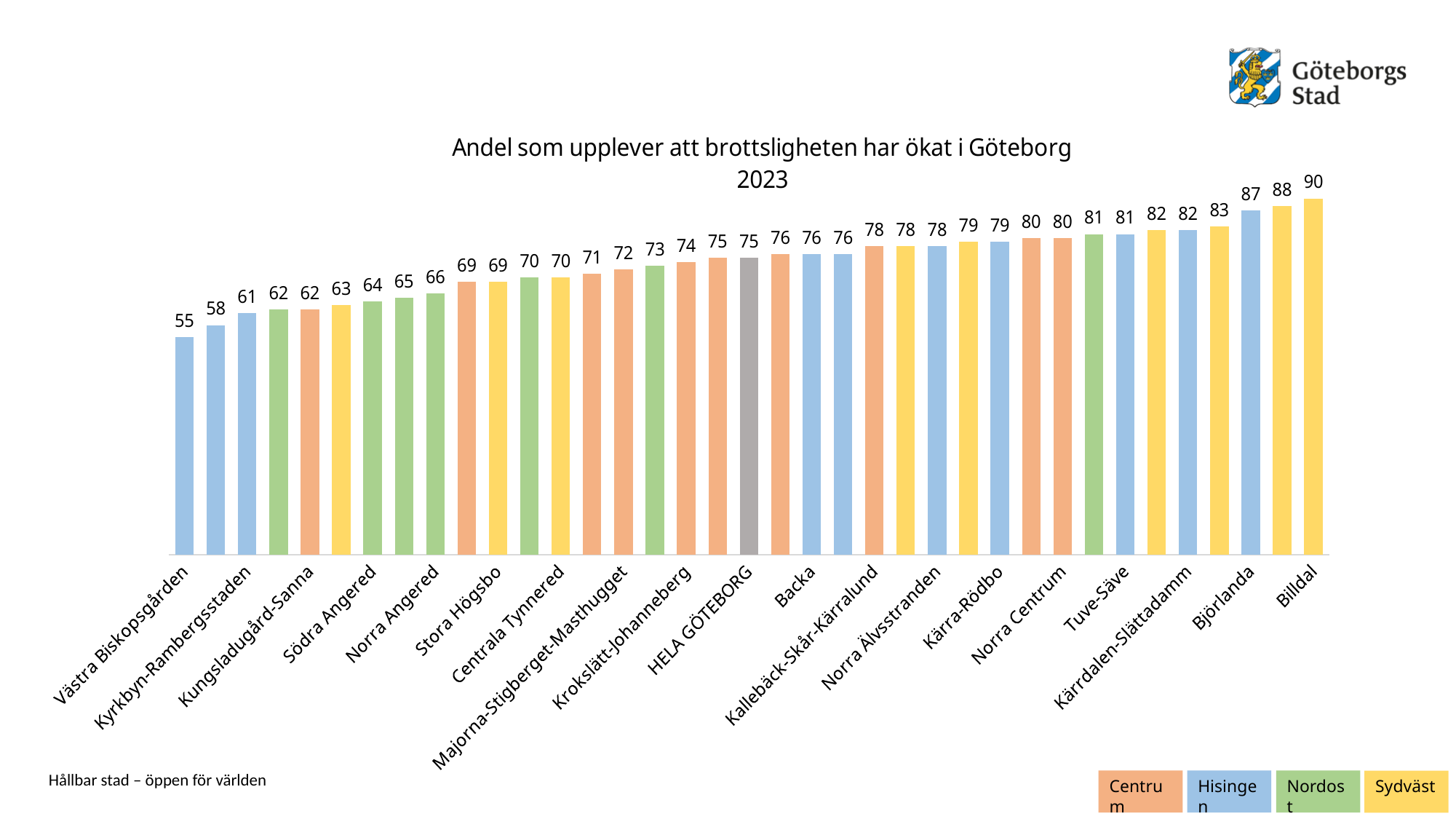
Which is larger, the value for Björlanda or the value for Backa? Björlanda What is the value for Björlanda? 87 What is the value for Backa? 76 Which labelled category has the lowest value? Västra Biskopsgården What is the value for Västra Biskopsgården? 55 What kind of chart is shown on the slide? Bar chart How many entries does the legend list? 4 What is the difference between the values for Billdal and Västra Biskopsgården? 35 What is the value for HELA GÖTEBORG? 75 Do the values rise or fall from left to right along the x axis? Rise Which labelled category has the highest value? Billdal What is the value for Billdal? 90